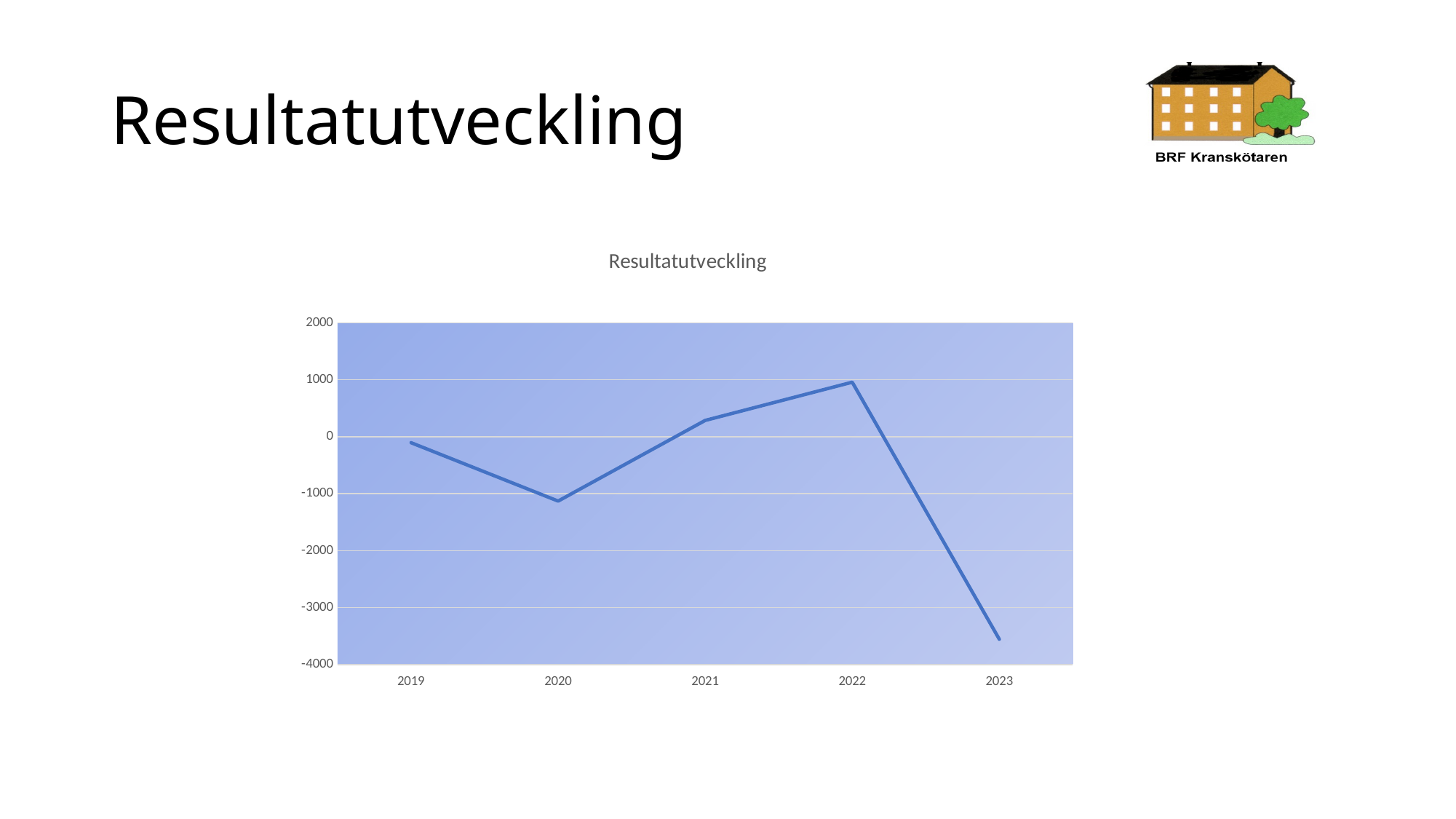
Is the value for 2023 greater or less than -3000? less Which year has the highest value in the chart? 2022 Which year has the larger value, 2020 or 2021? 2021 Which year has the larger value, 2022 or 2023? 2022 Does the value rise or fall from 2022 to 2023? fall How many years are plotted on the x axis of the chart? 5 What kind of chart is shown on the slide? line chart What is the title of the chart? Resultatutveckling Is the value for 2020 greater or less than 0? less Is the value for 2021 greater or less than 0? greater Which year has the lowest value in the chart? 2023